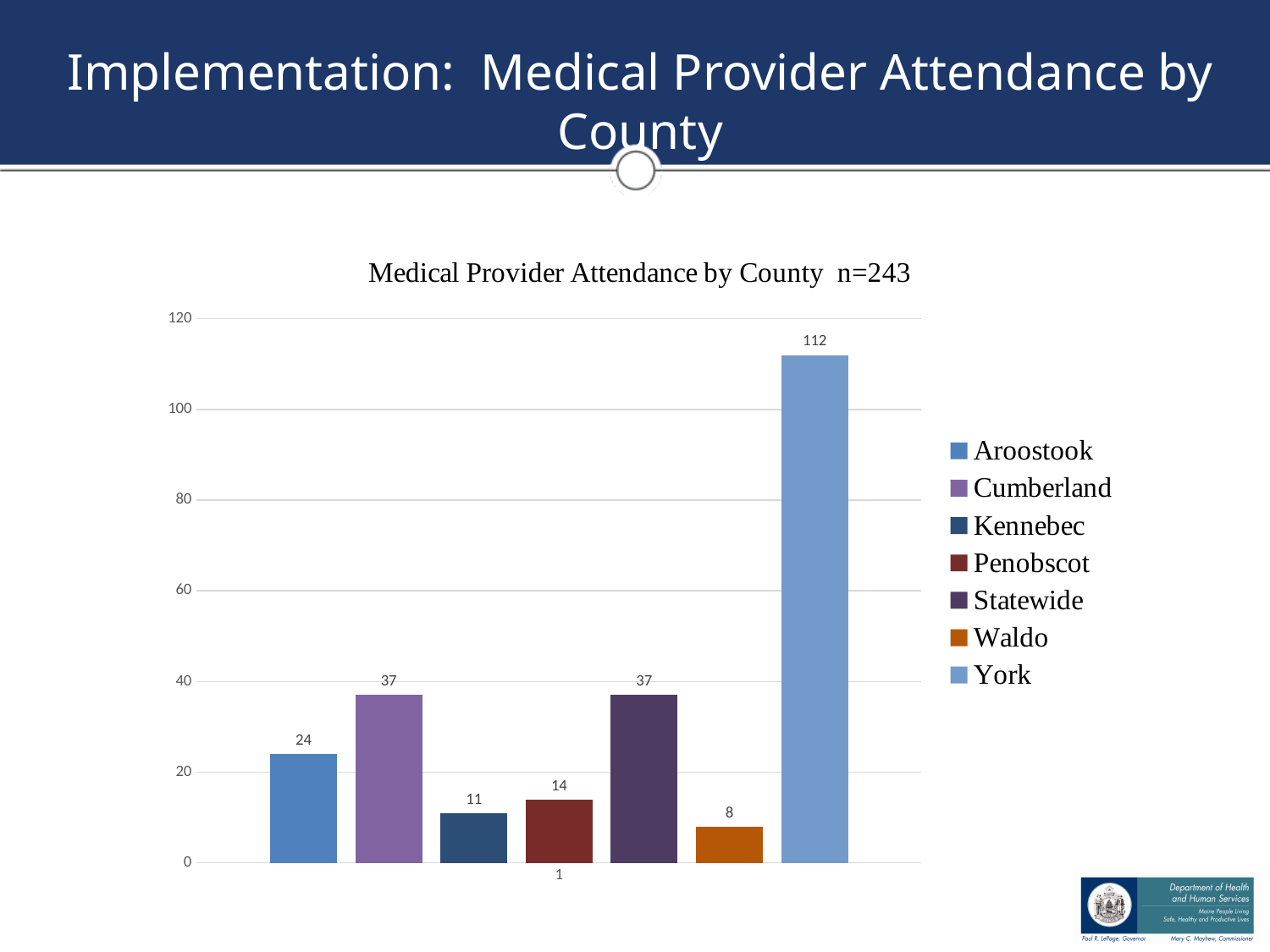
How many bars are plotted in the chart? 7 Which is larger, the value for Aroostook or the value for Penobscot? Aroostook What is the value for York? 112 What is the difference between the values for Penobscot and Kennebec? 3 What is the title of the chart? Medical Provider Attendance by County n=243 Which category has the highest value? York Which category has the lowest value? Waldo Is the value for York greater or less than 100? greater What is the value for Kennebec? 11 What is the value for Aroostook? 24 What is the value for Waldo? 8 What is the difference between the values for York and Cumberland? 75